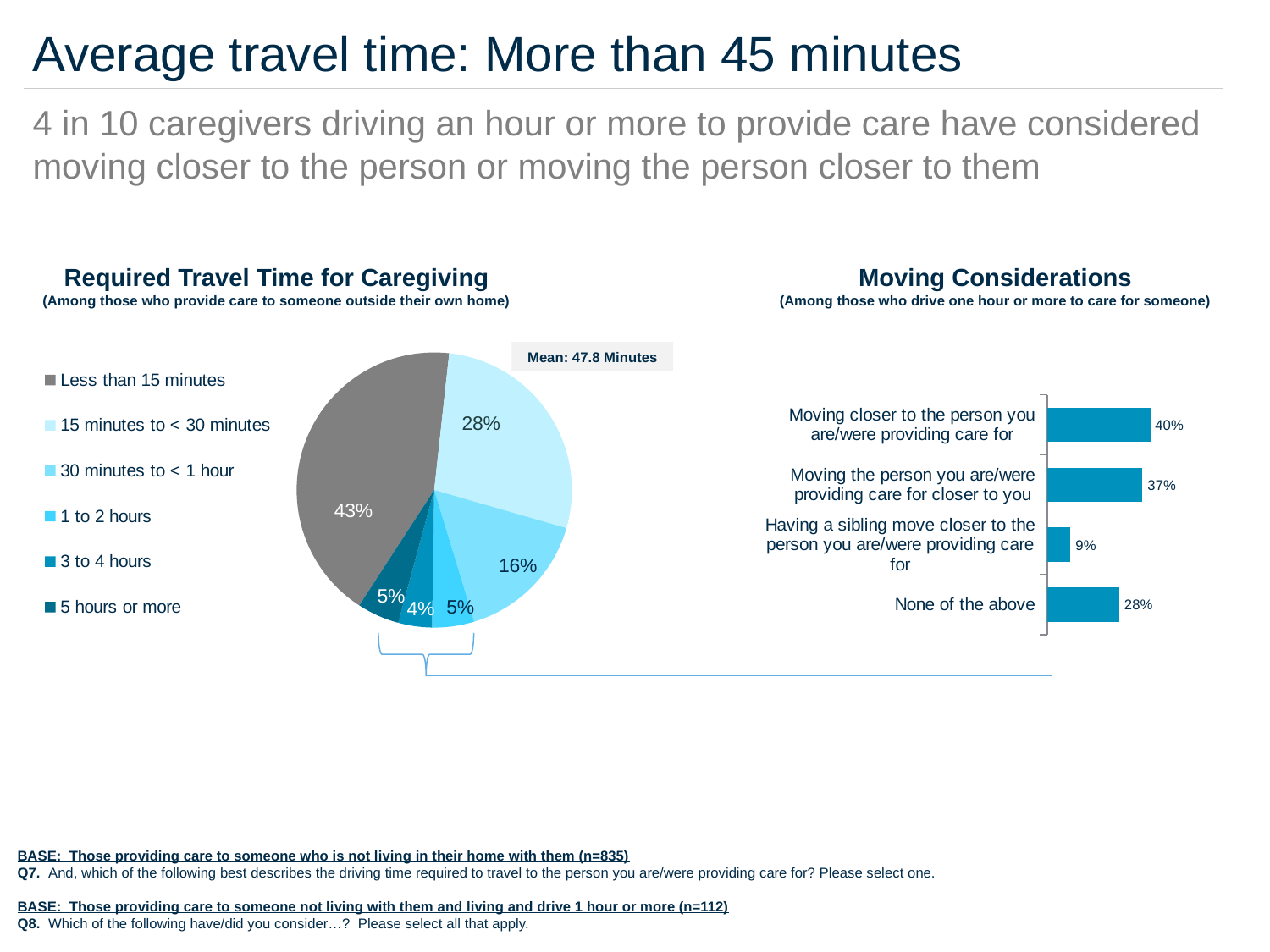
In the Required Travel Time for Caregiving pie chart, what percentage is shown for 30 minutes to < 1 hour? 16% In the Moving Considerations chart, what percentage considered moving closer to the person they are/were providing care for? 40% In the Moving Considerations chart, which option has the lowest percentage? Having a sibling move closer to the person you are/were providing care for What mean travel time is stated on the Required Travel Time for Caregiving chart? Mean: 47.8 Minutes What type of chart is the Moving Considerations chart? Bar chart How many categories does the legend of the Required Travel Time for Caregiving pie chart list? 6 In the Moving Considerations chart, what percentage selected None of the above? 28% In the Required Travel Time for Caregiving pie chart, which travel time category has the largest share? Less than 15 minutes In the Required Travel Time for Caregiving pie chart, which travel time category has the smallest share? 3 to 4 hours In the Required Travel Time for Caregiving pie chart, what percentage is shown for 15 minutes to < 30 minutes? 28% In the Required Travel Time for Caregiving pie chart, what share of caregivers travel less than 15 minutes? 43% In the Moving Considerations chart, what is the difference between moving closer to the person (40%) and moving the person closer to you (37%)? 3%